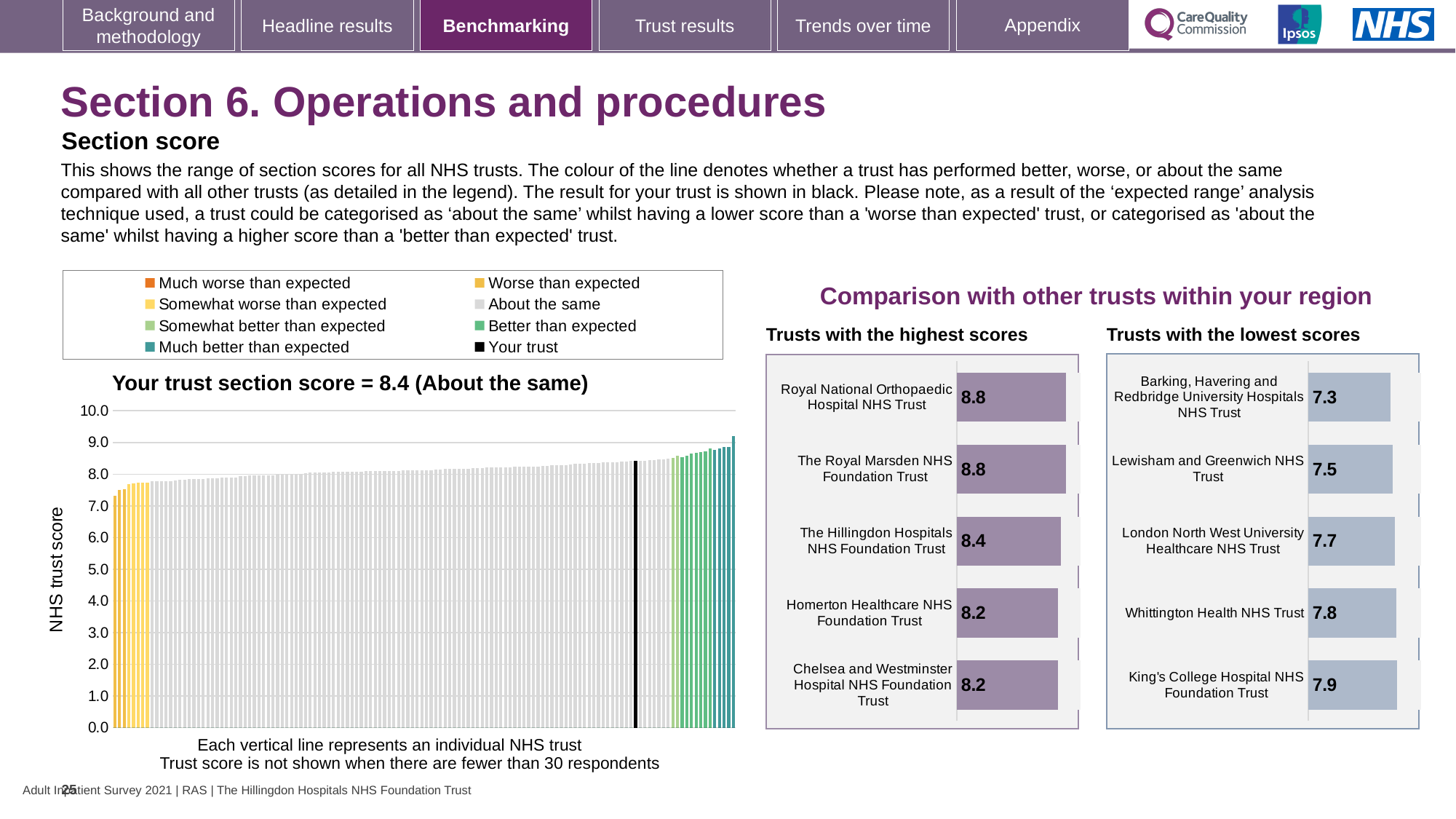
On the 'Trusts with the lowest scores' chart, which trust has the lowest score? Barking, Havering and Redbridge University Hospitals NHS Trust On the 'Your trust section score' chart, how many entries does the legend list? 8 On the 'Trusts with the highest scores' chart, how many trusts are shown? 5 On the 'Your trust section score' chart, what is the label of the vertical axis? NHS trust score What kind of chart is the 'Your trust section score' chart? Bar chart On the 'Trusts with the highest scores' chart, what is the score for Homerton Healthcare NHS Foundation Trust? 8.2 On the 'Trusts with the lowest scores' chart, what is the score for Whittington Health NHS Trust? 7.8 On the 'Trusts with the highest scores' chart, what is the difference between the score for Royal National Orthopaedic Hospital NHS Trust and the score for The Hillingdon Hospitals NHS Foundation Trust? 0.4 On the 'Your trust section score' chart, is the value of the tallest bar greater or less than 9.0? greater On the 'Your trust section score' chart, do the trust scores rise or fall from left to right? Rise On the 'Trusts with the lowest scores' chart, which has the larger score: Lewisham and Greenwich NHS Trust or King's College Hospital NHS Foundation Trust? King's College Hospital NHS Foundation Trust On the 'Your trust section score' chart, what is the section score for your trust? 8.4